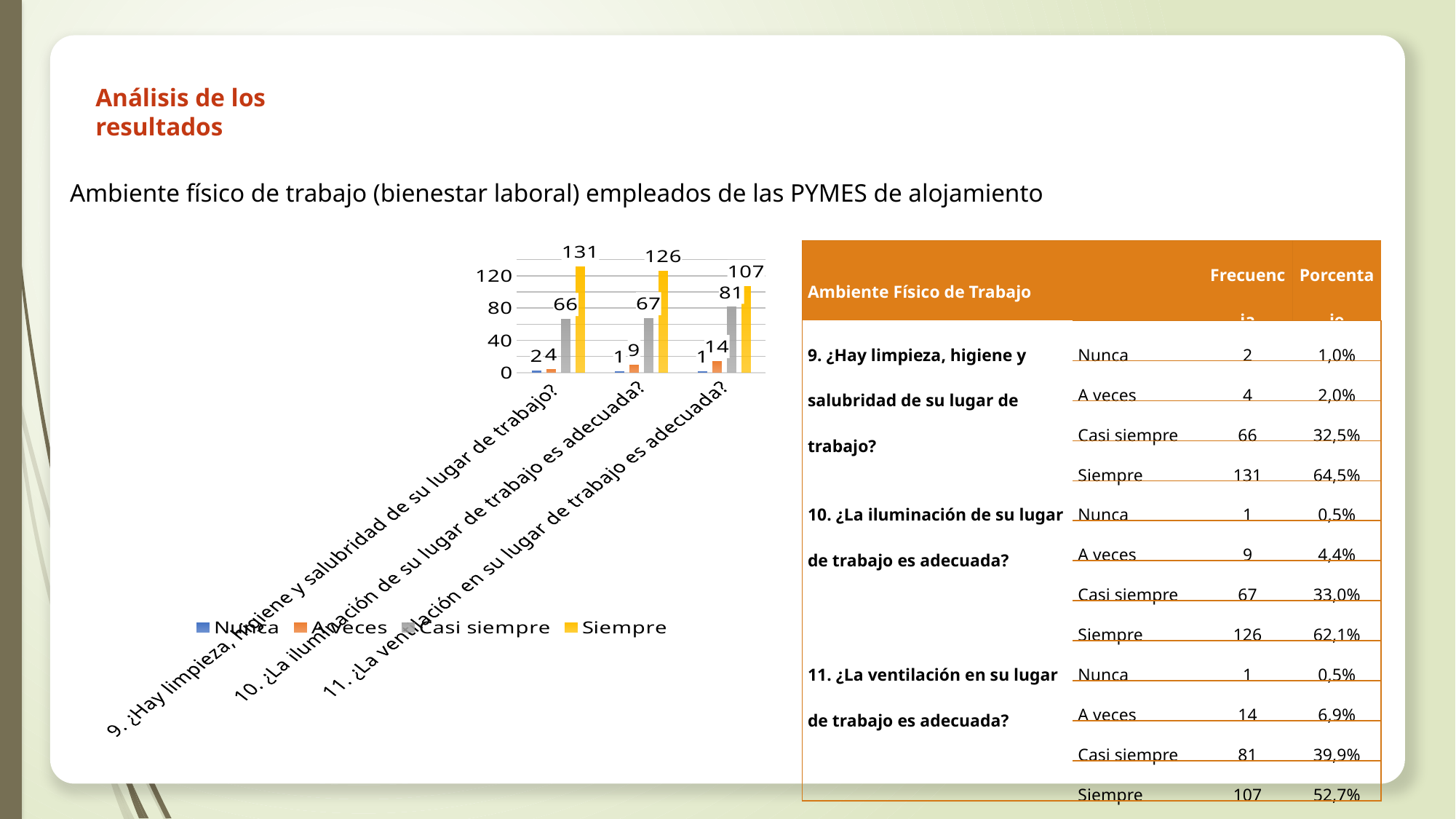
How many question categories are plotted on the x axis of the chart? 3 What is the value of the Casi siempre bar for question 10 (¿La iluminación de su lugar de trabajo es adecuada?)? 67 Do the Siempre values rise or fall from question 9 to question 11 along the x axis? fall What is the value of the A veces bar for question 11 (¿La ventilación en su lugar de trabajo es adecuada?)? 14 Which is larger: the Casi siempre value for question 11 or the Casi siempre value for question 9? question 11 Which question category has the highest Siempre value? 9. ¿Hay limpieza, higiene y salubridad de su lugar de trabajo? Which series is shown in yellow in the chart legend? Siempre What is the value of the Siempre bar for question 9 (¿Hay limpieza, higiene y salubridad de su lugar de trabajo?)? 131 What is the difference between the Siempre values for question 9 and question 11? 24 Which question category has the lowest Siempre value? 11. ¿La ventilación en su lugar de trabajo es adecuada? What kind of chart is shown on the slide? bar chart How many series does the chart legend list? 4